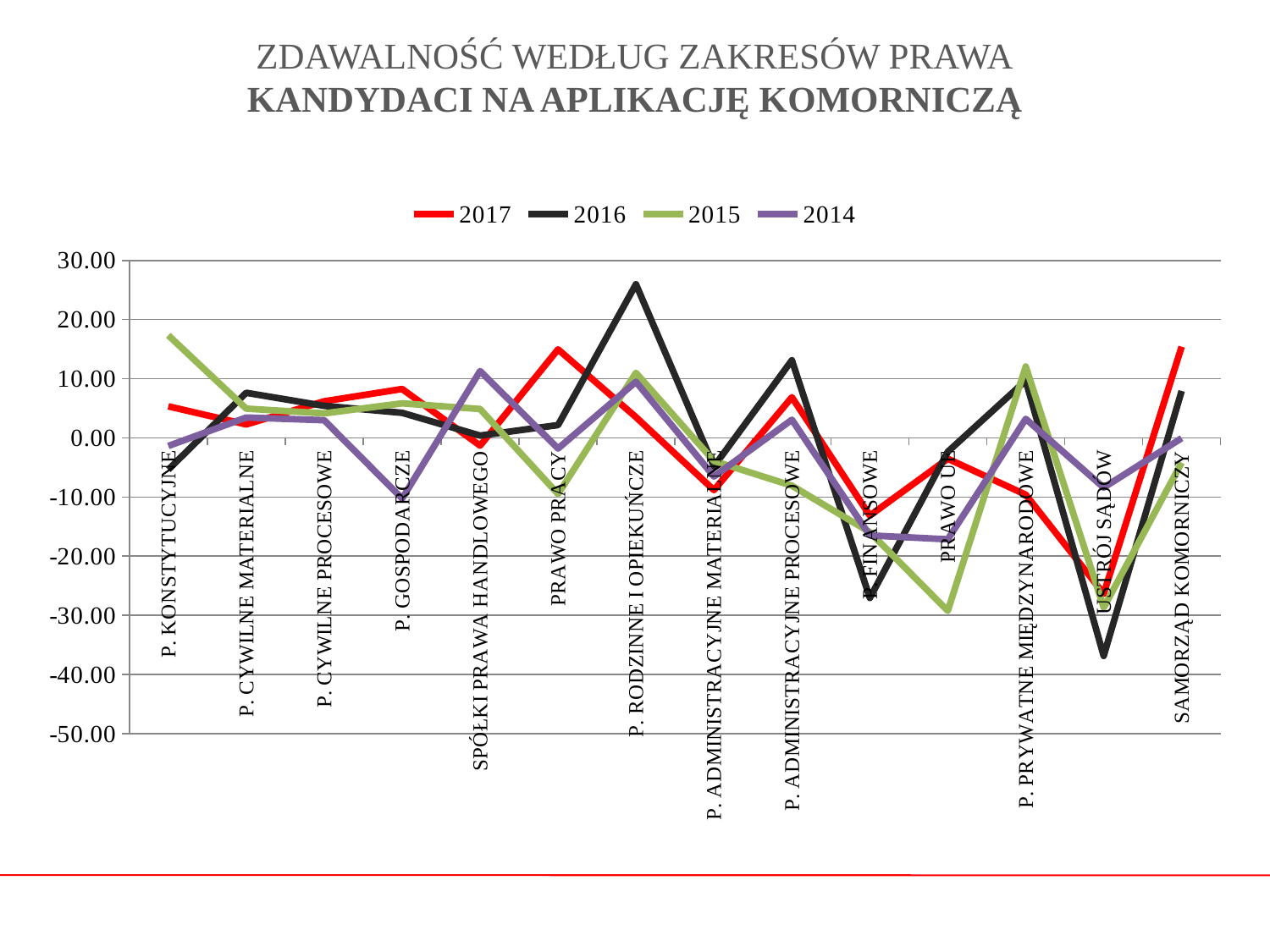
Is the 2015 value for PRAWO UE greater or less than -20.00? less Is the 2014 value for P. GOSPODARCZE greater or less than 0.00? less What kind of chart is shown on the slide? line chart How many series does the legend list? 4 For the 2017 series, which category has the lowest value? USTRÓJ SĄDÓW For the 2016 series, which category has the lowest value? USTRÓJ SĄDÓW At P. KONSTYTUCYJNE, which series has the larger value, 2015 or 2016? 2015 Is the 2016 value for P. RODZINNE I OPIEKUŃCZE greater or less than 20.00? greater How many categories are plotted along the x axis? 14 Which colour is used for the 2017 series in the legend? red For the 2016 series, which category has the highest value? P. RODZINNE I OPIEKUŃCZE For the 2015 series, which category has the highest value? P. KONSTYTUCYJNE